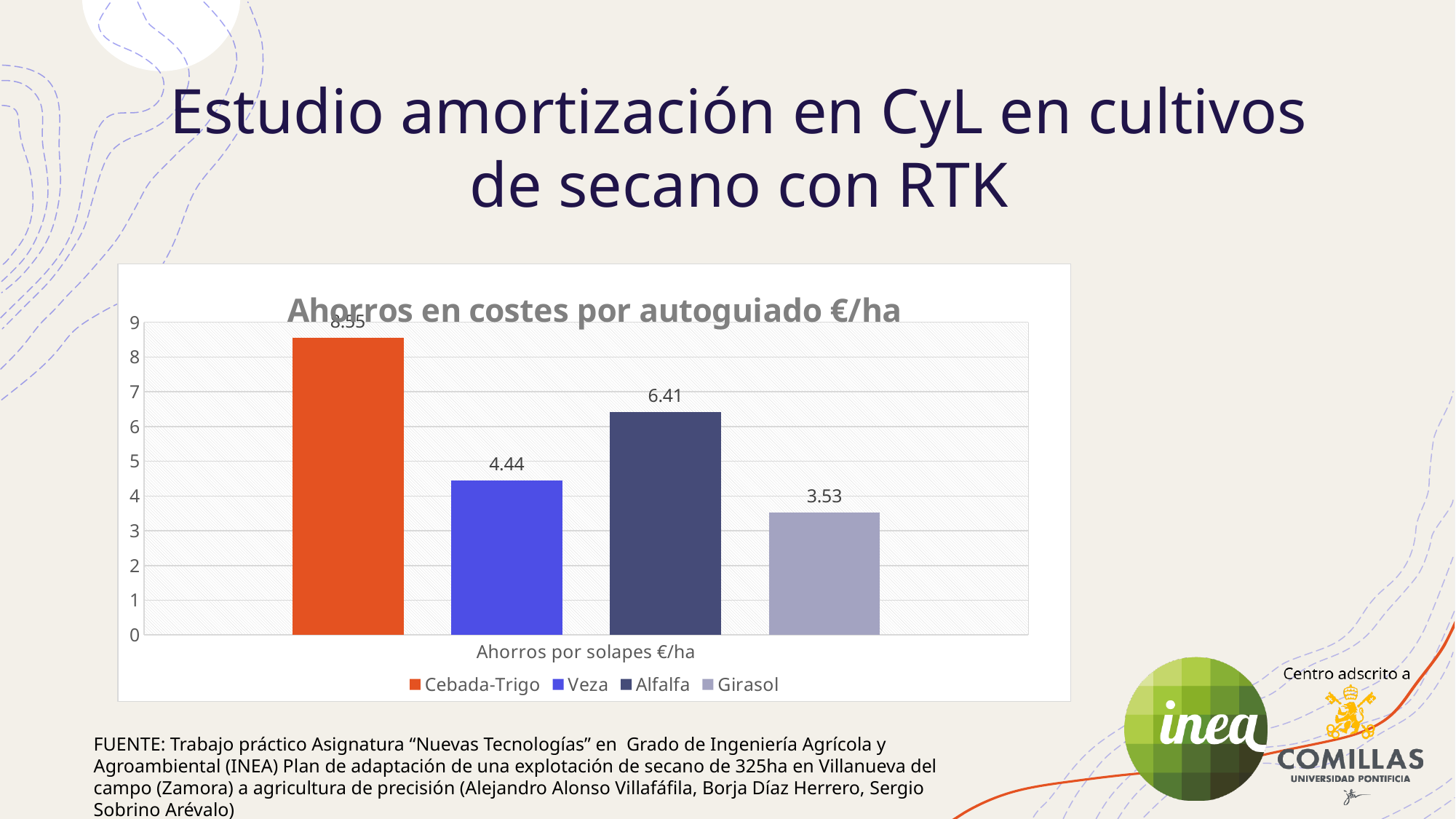
What is the value for Veza in the chart? 4.44 What is the title of the chart? Ahorros en costes por autoguiado €/ha Which crop has the highest savings value in the chart? Cebada-Trigo What kind of chart is shown on the slide? Bar chart How many series does the legend list? 4 Which is larger, the value for Veza or the value for Alfalfa? Alfalfa What is the difference between the values for Cebada-Trigo and Girasol? 5.02 What is the value for Alfalfa in the chart? 6.41 What is the value for Girasol in the chart? 3.53 Which crop has the lowest savings value in the chart? Girasol What is the difference between the values for Alfalfa and Veza? 1.97 What is the value for Cebada-Trigo in the chart? 8.55